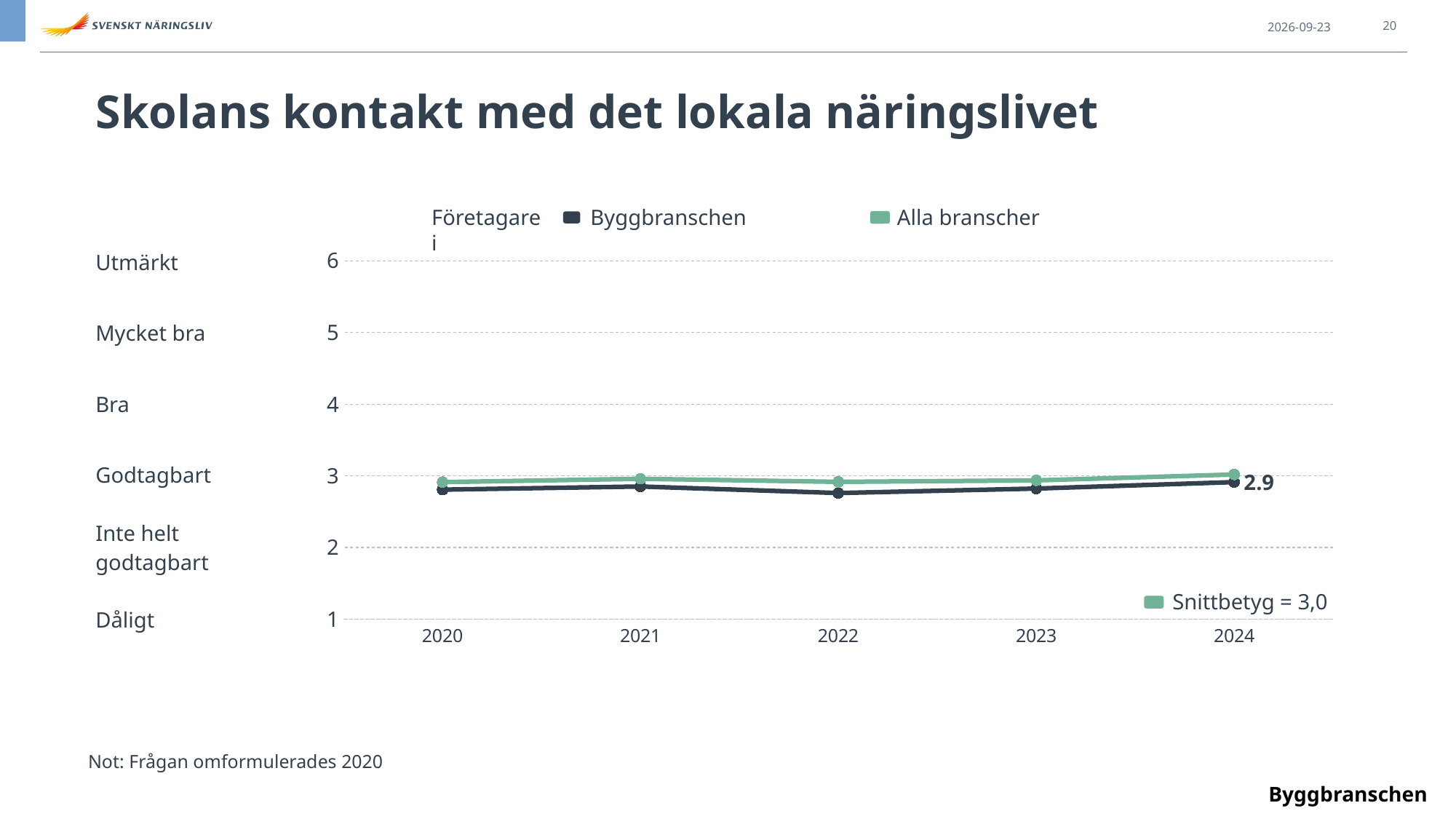
Is the value for Byggbranschen in 2020 greater or less than 3? less Does the Byggbranschen line rise or fall from 2022 to 2024? rise What is the title of the slide? Skolans kontakt med det lokala näringslivet How many years are plotted along the x axis? 5 Is the value for Byggbranschen in 2022 greater or less than 3? less What average rating (Snittbetyg) is shown in the label at the bottom right of the chart? 3,0 What is the value for Byggbranschen in 2024? 2.9 How many series does the chart legend list? 2 What kind of chart is shown on the slide? line chart In 2022, which series has the higher value, Byggbranschen or Alla branscher? Alla branscher